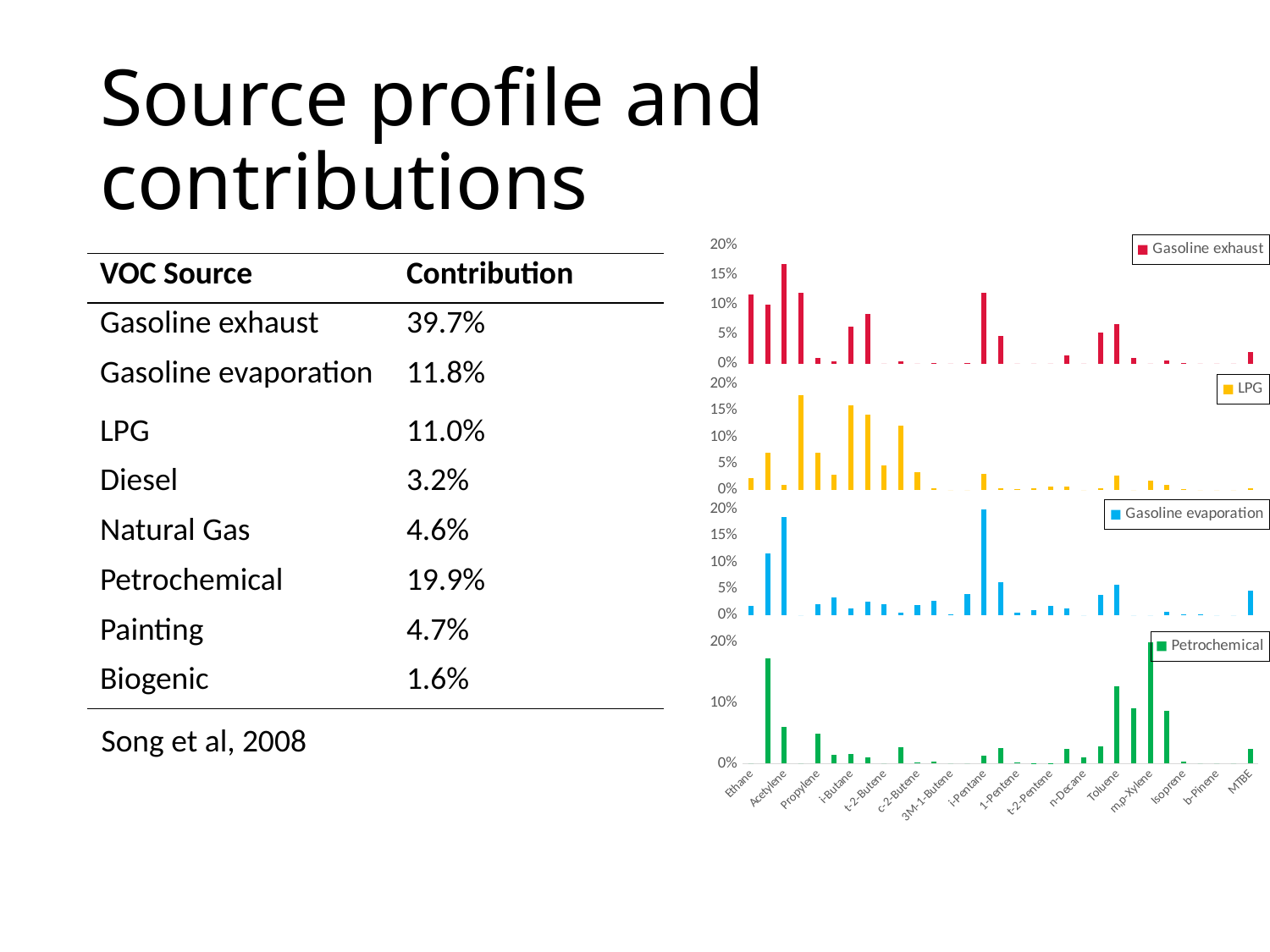
In the Petrochemical chart, which is larger, the value for Ethane or the value for MTBE? MTBE What colour are the bars in the LPG chart? yellow In the Gasoline evaporation chart, which category has the tallest bar? i-Pentane What kind of chart is the Petrochemical chart at the bottom right of the slide? bar chart How many series does the legend of the Gasoline exhaust chart list? 1 In the Gasoline exhaust chart, which category has the tallest bar? Acetylene In the Petrochemical chart, is the value for m,p-Xylene greater or less than 10%? greater How many charts are shown on the right side of the slide? 4 In the Petrochemical chart, is the value for MTBE greater or less than 10%? less In the Petrochemical chart, which category has the tallest bar? m,p-Xylene In the Gasoline evaporation chart, is the value for i-Pentane greater or less than 15%? greater